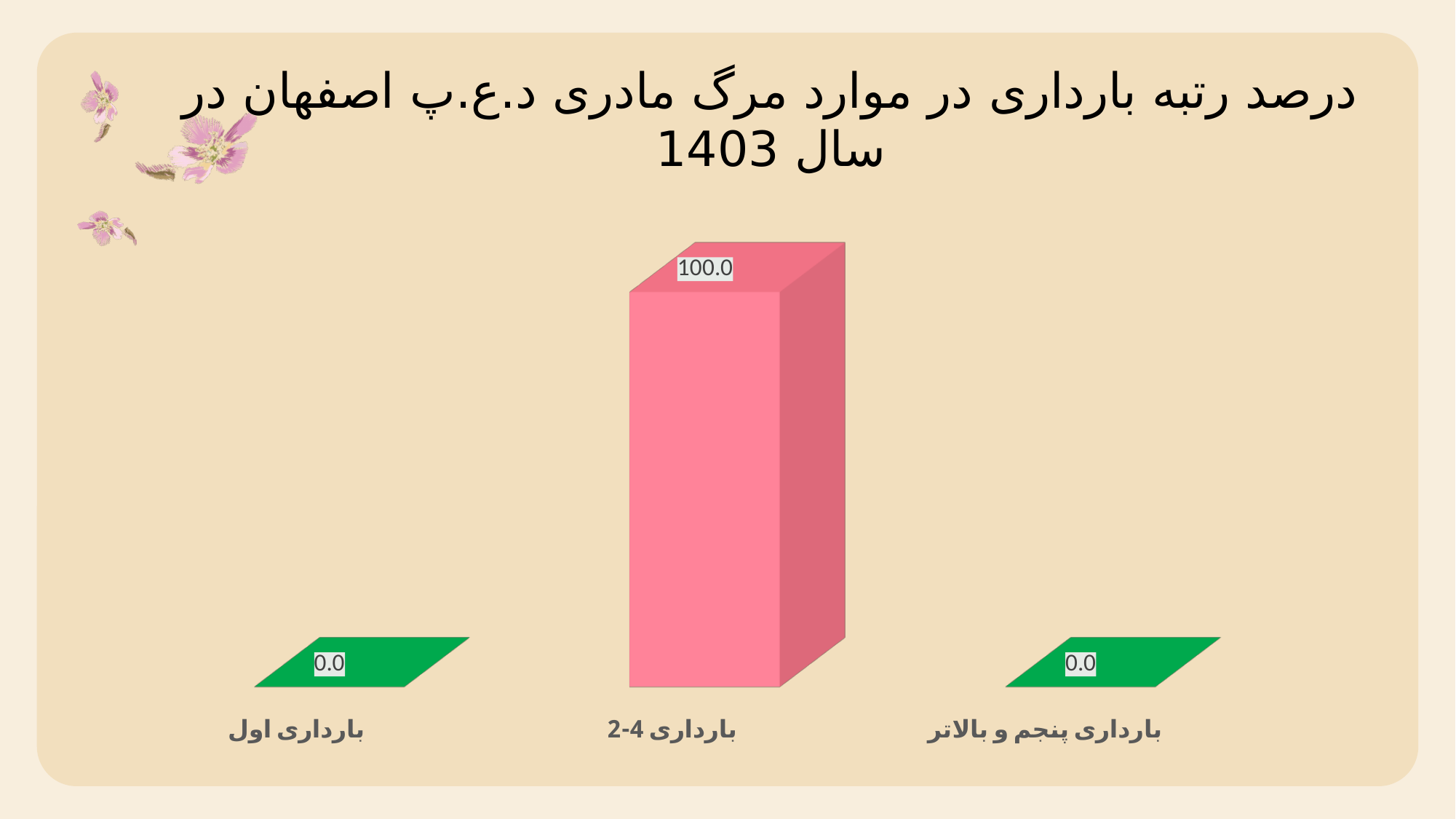
What is the total of the three values shown on the chart? 100.0 How many categories are shown on the chart? 3 What colour is the bar for بارداری 2-4? Pink What is the value shown for بارداری 2-4? 100.0 What is the difference between the values for بارداری 2-4 and بارداری اول? 100.0 Which category has the highest value? بارداری 2-4 What is the value shown for بارداری اول? 0.0 How many categories have a value of 0.0? 2 What is the value shown for بارداری پنجم و بالاتر? 0.0 Which year is mentioned in the chart title? 1403 What kind of chart is shown on the slide? Bar chart Which is larger, the value for بارداری 2-4 or the value for بارداری پنجم و بالاتر? بارداری 2-4